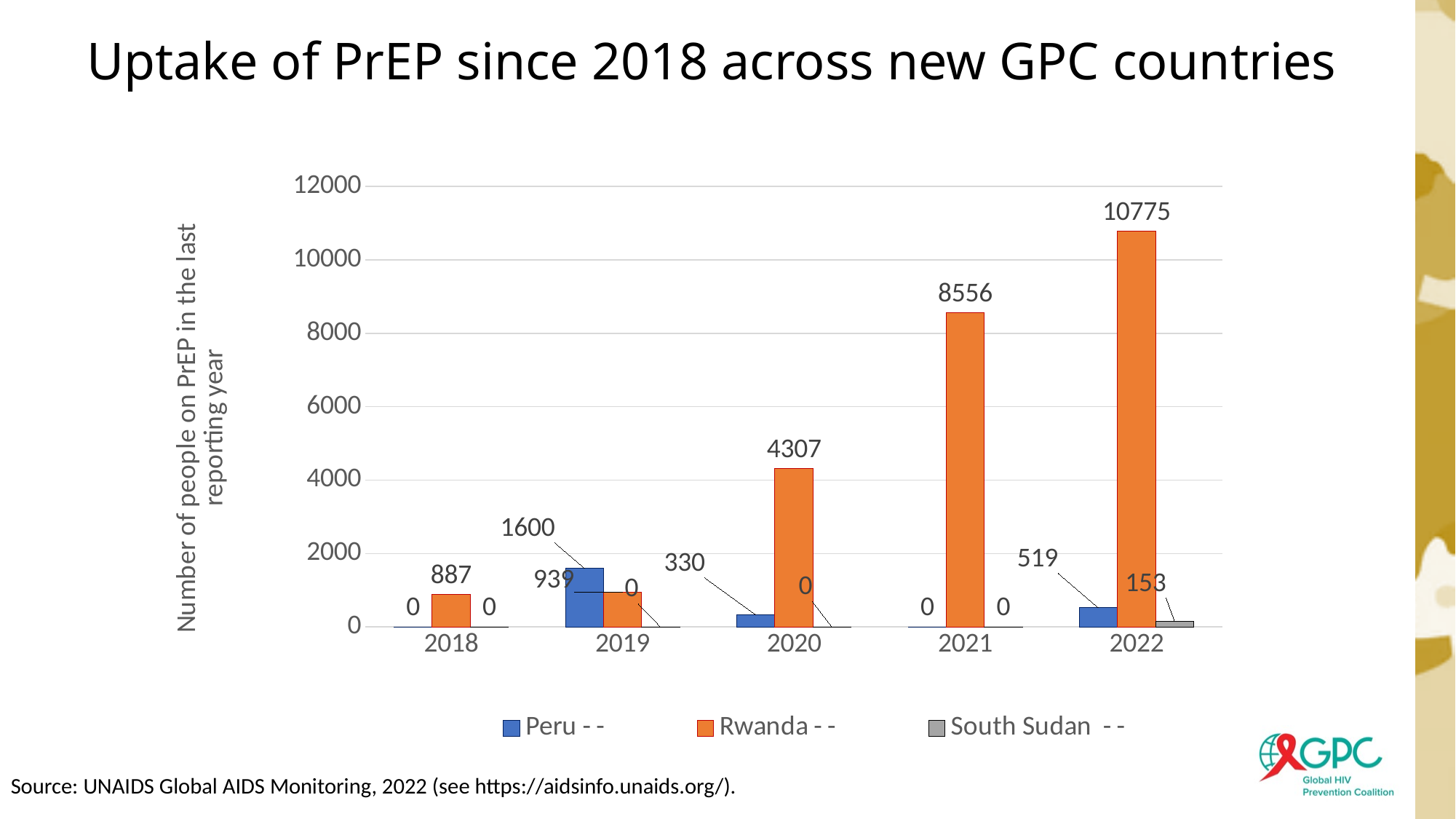
What is the value for Peru in 2019? 1600 What is the value for South Sudan in 2022? 153 What is the value for Rwanda in 2021? 8556 In 2019, which is larger, the value for Peru or the value for Rwanda? Peru In which year is the Rwanda value highest? 2022 What is the value for Peru in 2020? 330 How many series does the legend list? 3 How many years are shown on the x axis? 5 Do the Rwanda values rise or fall from 2018 to 2022? rise What is the difference between the Rwanda values for 2022 and 2021? 2219 What kind of chart is shown on the slide? bar chart What is the value for Rwanda in 2022? 10775